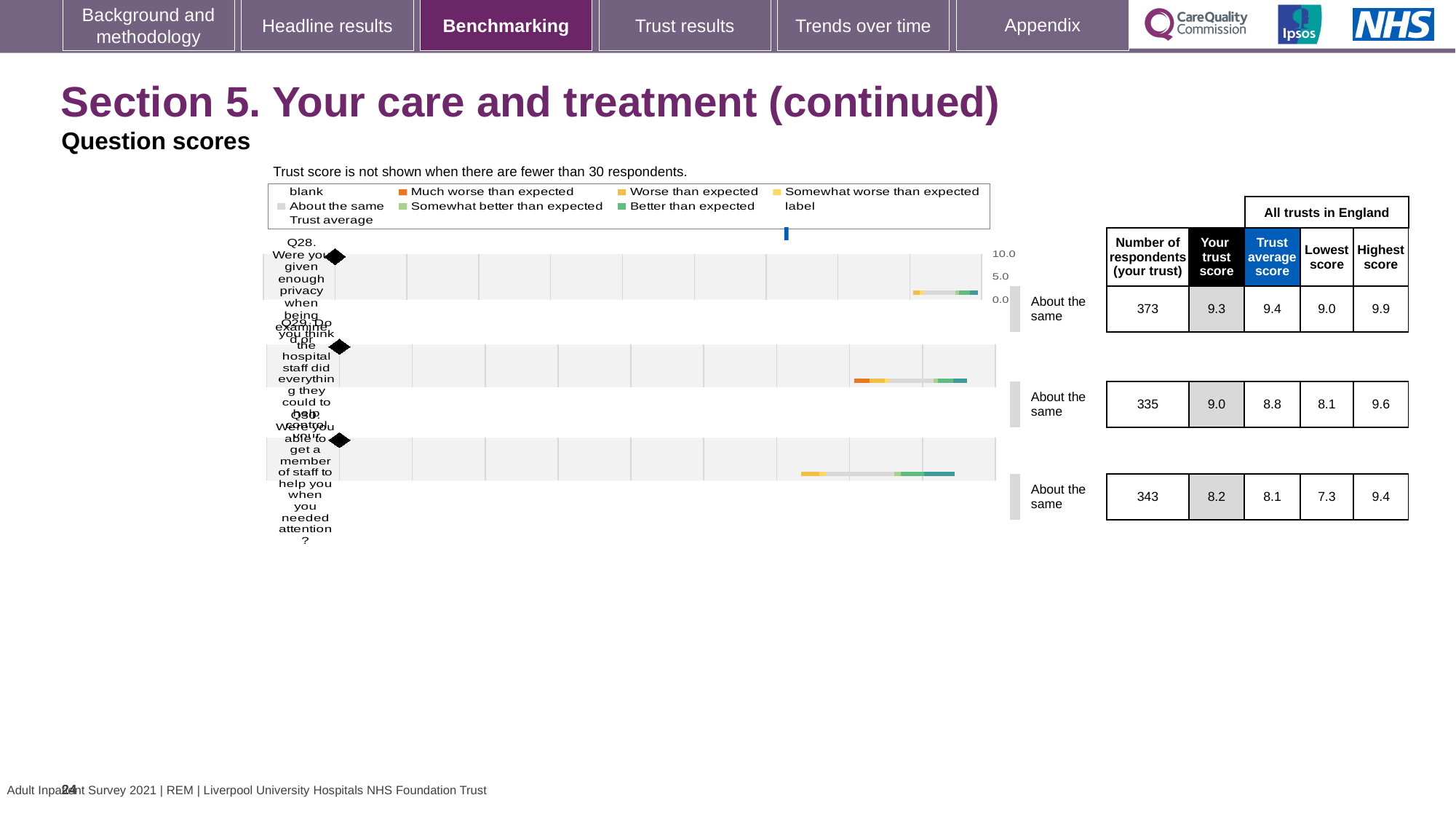
What is the difference between the highest score and the lowest score for Q28? 0.9 What is the highest score across all trusts in England for Q30 (Were you able to get a member of staff to help you when you needed attention?)? 9.4 Which question has the highest trust score on this slide? Q28 How many respondents answered Q29 (Do you think the hospital staff did everything they could to help control your pain?)? 335 What is the trust average score for Q29? 8.8 What kind of chart is used to show the question scores? Bar chart How many questions are shown on this slide? 3 Which question has the lowest trust score on this slide? Q30 What is the trust score for Q28 (Were you given enough privacy when being examined or treated?)? 9.3 What benchmark category is shown for Q30? About the same What is the difference between the trust score and the trust average score for Q29? 0.2 For Q28, which is larger: the trust score or the trust average score? Trust average score